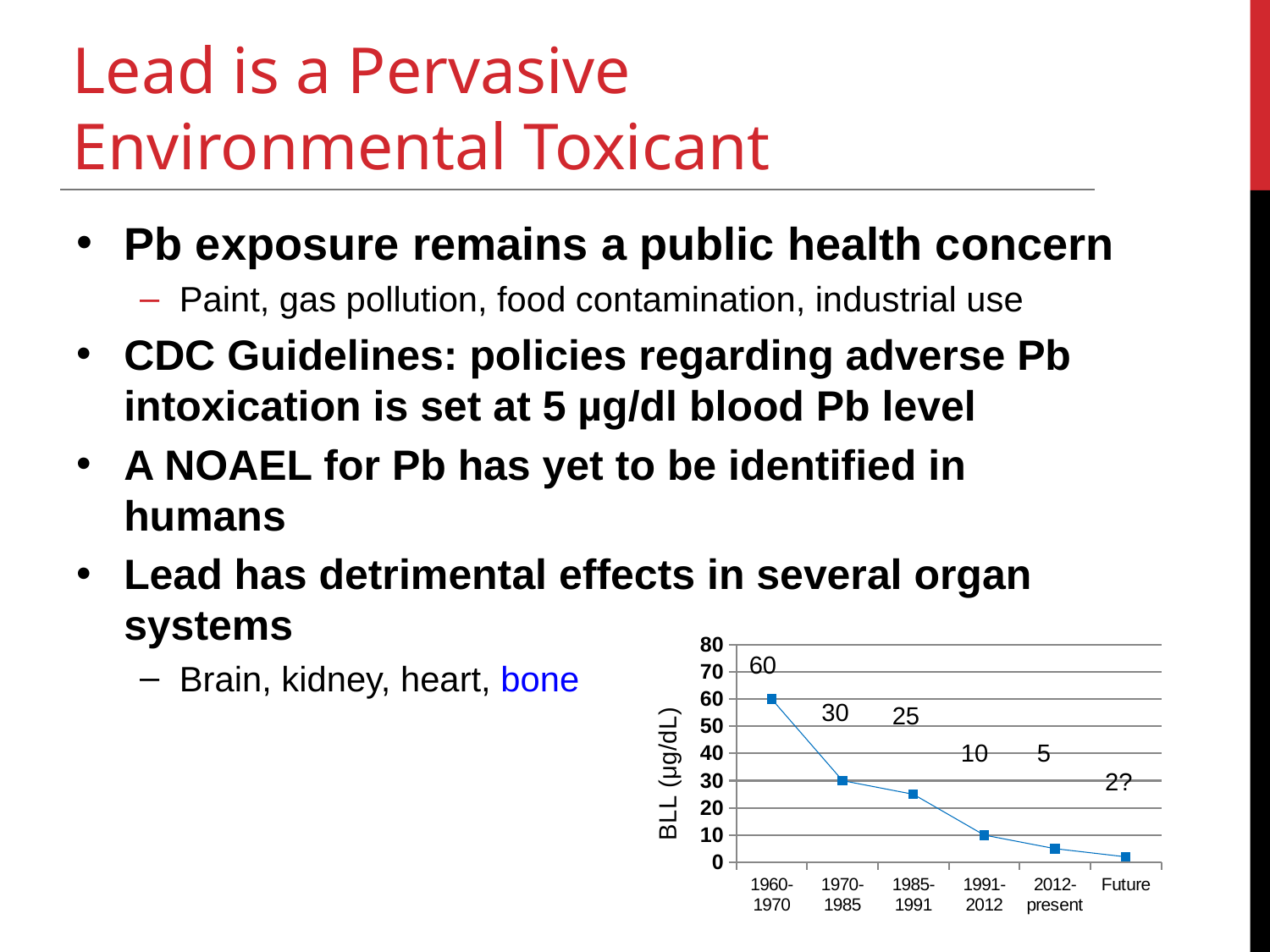
What is the BLL value for 1970-1985? 30 Which is larger, the BLL for 1970-1985 or for 1985-1991? 1970-1985 What is the BLL value for 1960-1970? 60 What is the BLL value for 1991-2012? 10 What is the difference in BLL between 1960-1970 and 1970-1985? 30 What data label is shown for the Future point? 2? What is the difference in BLL between 1985-1991 and 1991-2012? 15 Do the BLL values rise or fall along the x axis? fall What is the BLL value for 2012-present? 5 How many periods are plotted on the x axis? 6 Which period has the highest BLL value? 1960-1970 What kind of chart is shown? line chart